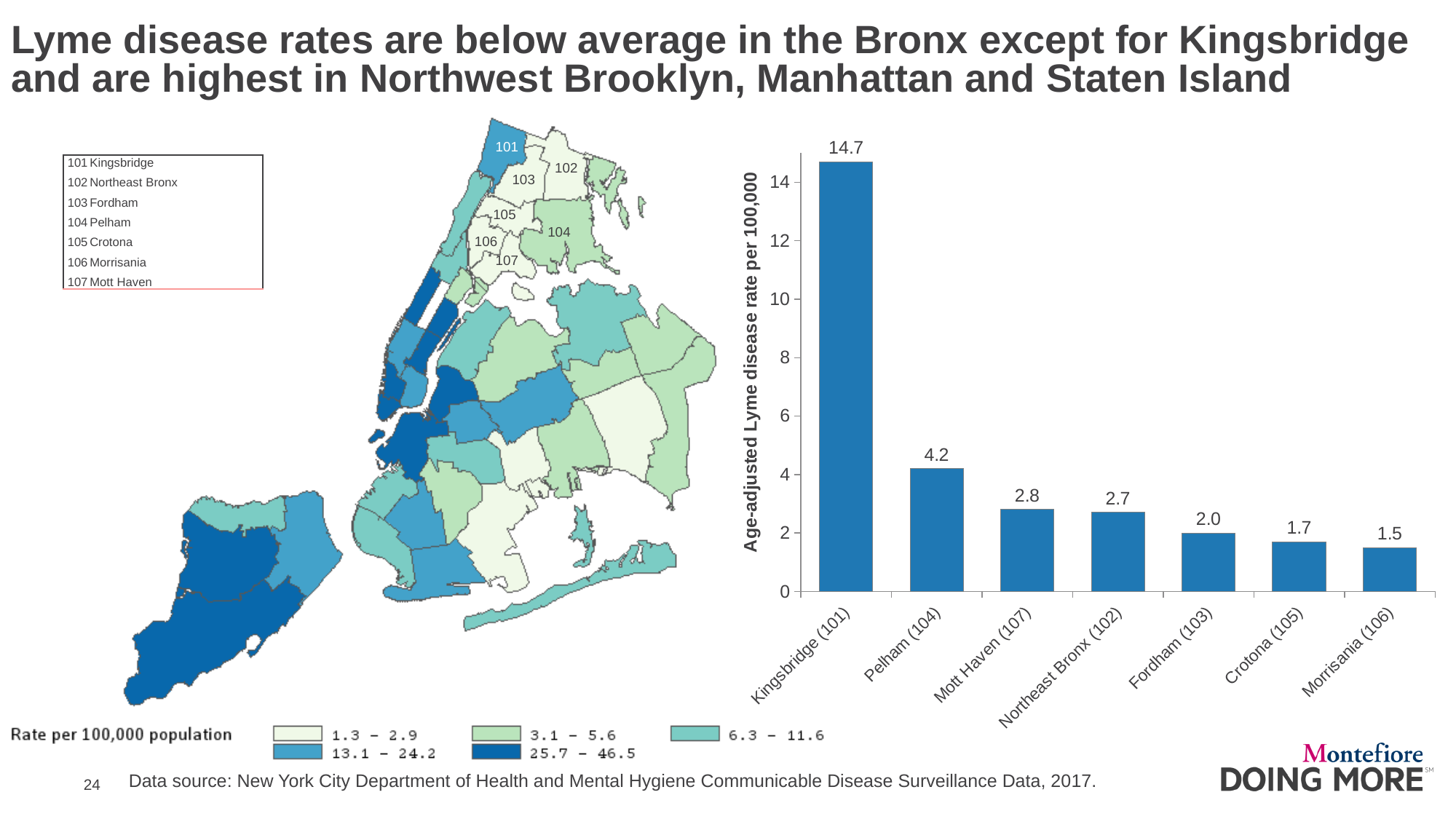
In the bar chart, is the value for Kingsbridge (101) greater or less than 12? greater In the bar chart, what is the age-adjusted Lyme disease rate per 100,000 for Pelham (104)? 4.2 In the bar chart, what is the age-adjusted Lyme disease rate per 100,000 for Morrisania (106)? 1.5 What kind of chart is shown on the right side of the slide? Bar chart In the bar chart, which has a higher Lyme disease rate, Pelham (104) or Fordham (103)? Pelham (104) In the bar chart, what is the age-adjusted Lyme disease rate per 100,000 for Fordham (103)? 2.0 In the bar chart, what is the difference between the Lyme disease rates for Kingsbridge (101) and Pelham (104)? 10.5 In the bar chart, which neighborhood has the lowest age-adjusted Lyme disease rate? Morrisania (106) How many neighborhoods are shown in the bar chart? 7 In the bar chart, what is the difference between the Lyme disease rates for Crotona (105) and Morrisania (106)? 0.2 In the bar chart, what is the age-adjusted Lyme disease rate per 100,000 for Kingsbridge (101)? 14.7 In the bar chart, which neighborhood has the highest age-adjusted Lyme disease rate? Kingsbridge (101)